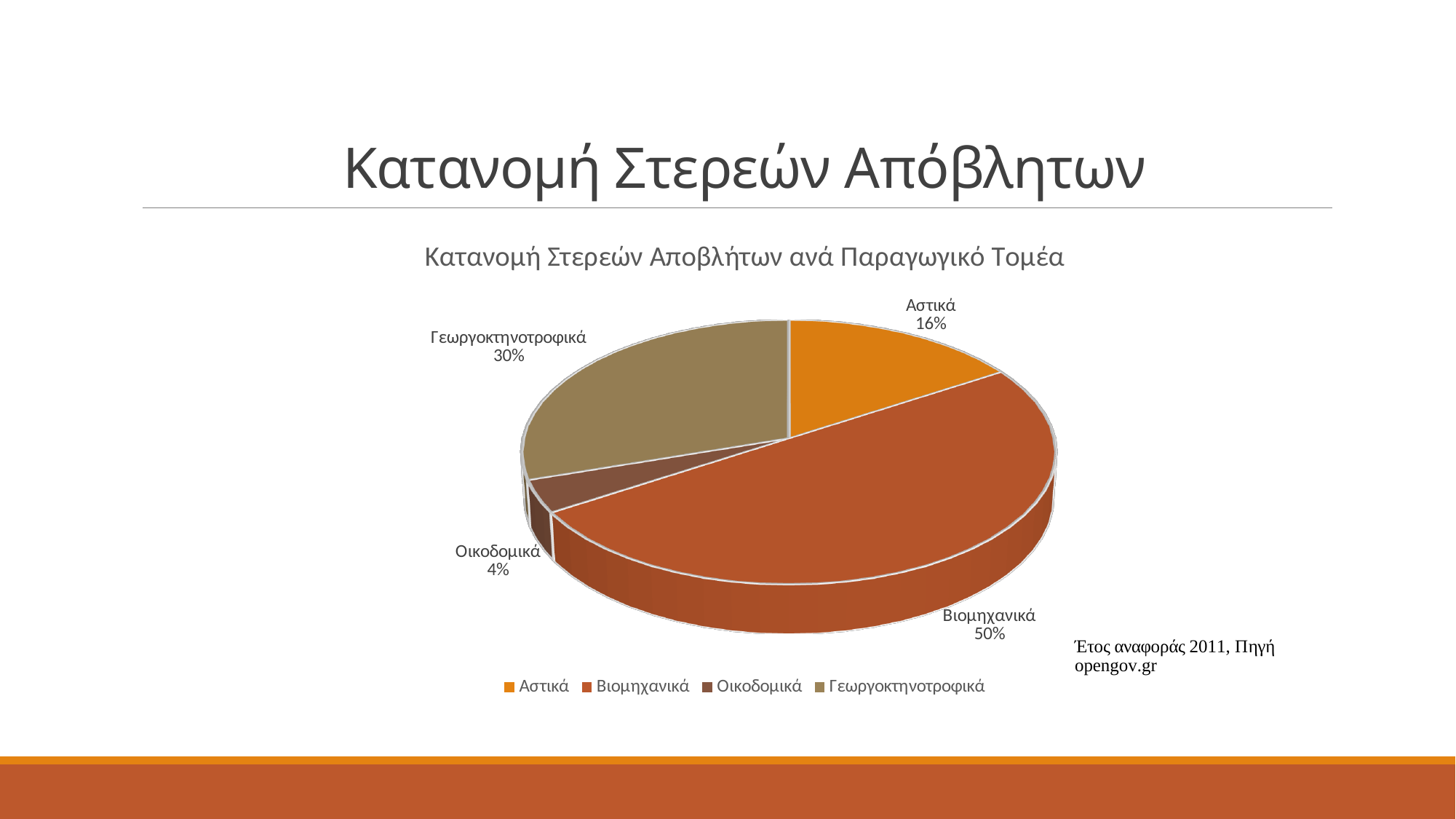
What is the title of the chart? Κατανομή Στερεών Αποβλήτων ανά Παραγωγικό Τομέα How many categories are shown in the pie chart? 4 Which is larger, the share for Αστικά or the share for Γεωργοκτηνοτροφικά? Γεωργοκτηνοτροφικά Which legend entry is listed first? Αστικά What share of the pie does Βιομηχανικά represent? 50% Which category has the largest slice of the pie? Βιομηχανικά What is the value shown for Οικοδομικά? 4% What kind of chart is shown on the slide? Pie chart What is the value shown for Γεωργοκτηνοτροφικά? 30% What is the difference in percentage points between Γεωργοκτηνοτροφικά and Αστικά? 14 What is the value shown for Αστικά? 16% Which category has the smallest slice of the pie? Οικοδομικά